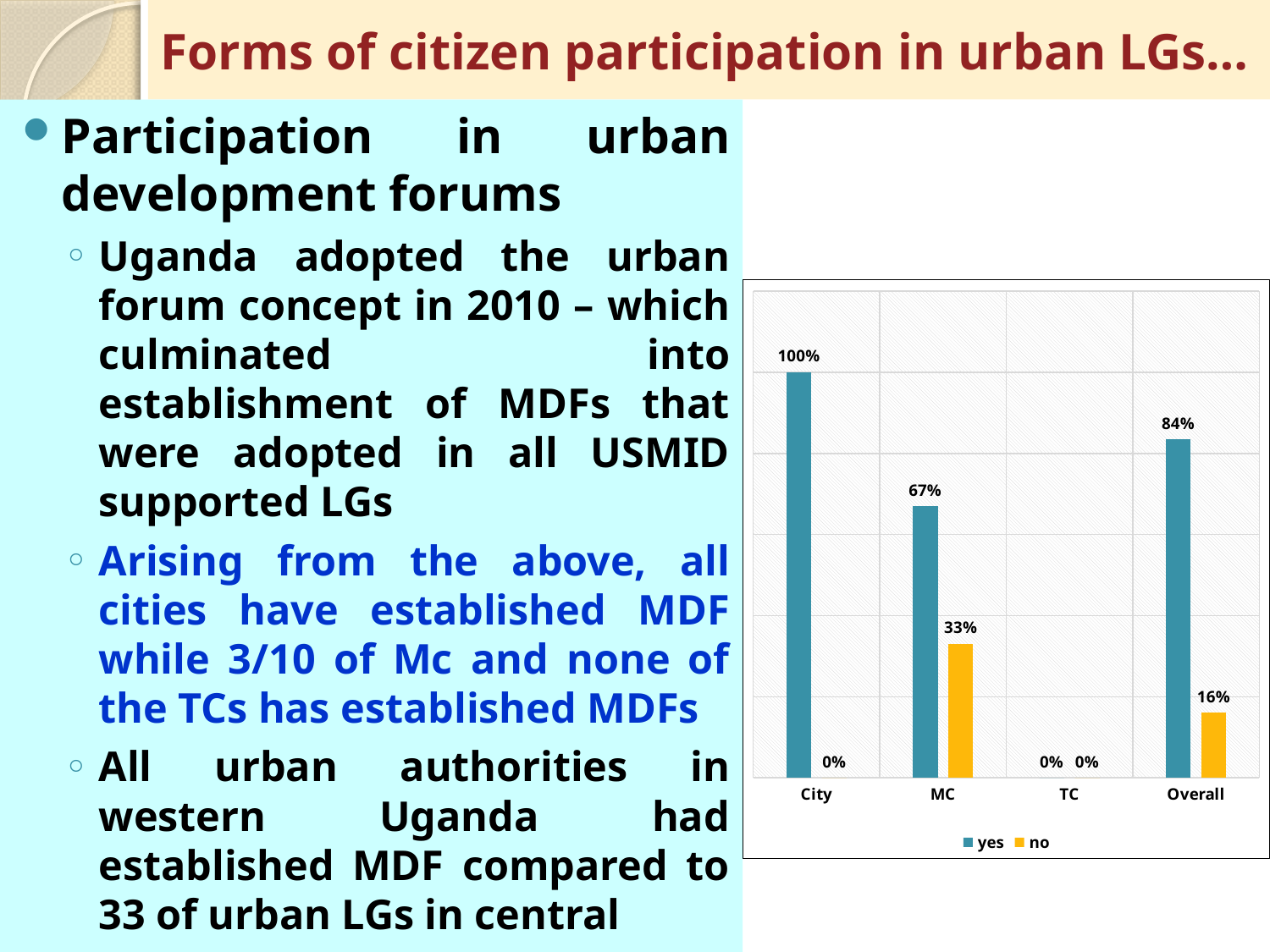
Which category has the highest 'yes' value? City What is the 'yes' value for City? 100% What is the difference between the 'yes' and 'no' values for MC? 34% What is the 'no' value for TC? 0% How many series does the legend list? 2 How many categories are shown on the x axis? 4 What kind of chart is shown on the slide? Bar chart What is the 'yes' value for Overall? 84% Which is larger, the 'yes' value for MC or the 'yes' value for Overall? Overall What is the 'no' value for MC? 33% Which category has the highest 'no' value? MC What is the difference between the 'yes' values for City and Overall? 16%